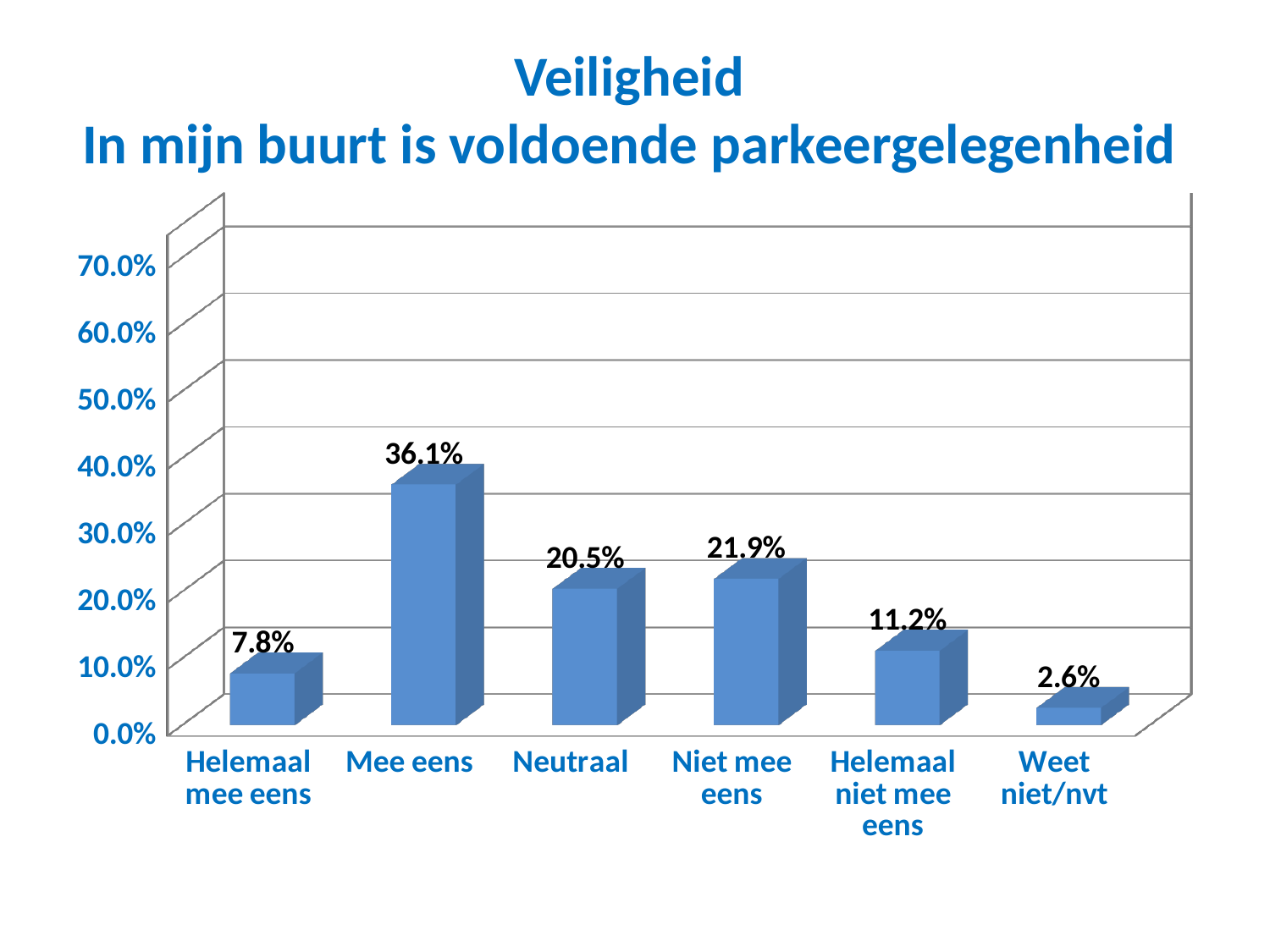
Is the value for Neutraal greater or less than 30.0%? less Which category has the lowest value? Weet niet/nvt What is the difference between the values for Mee eens and Niet mee eens? 14.2% What is the value for Mee eens? 36.1% What is the title of the chart? Veiligheid In mijn buurt is voldoende parkeergelegenheid What is the value for Weet niet/nvt? 2.6% What is the difference between the values for Neutraal and Helemaal mee eens? 12.7% Which category has the highest value? Mee eens What kind of chart is shown on the slide? bar chart Which is larger, the value for Helemaal mee eens or the value for Helemaal niet mee eens? Helemaal niet mee eens What is the value for Helemaal niet mee eens? 11.2% How many categories are shown on the x axis? 6